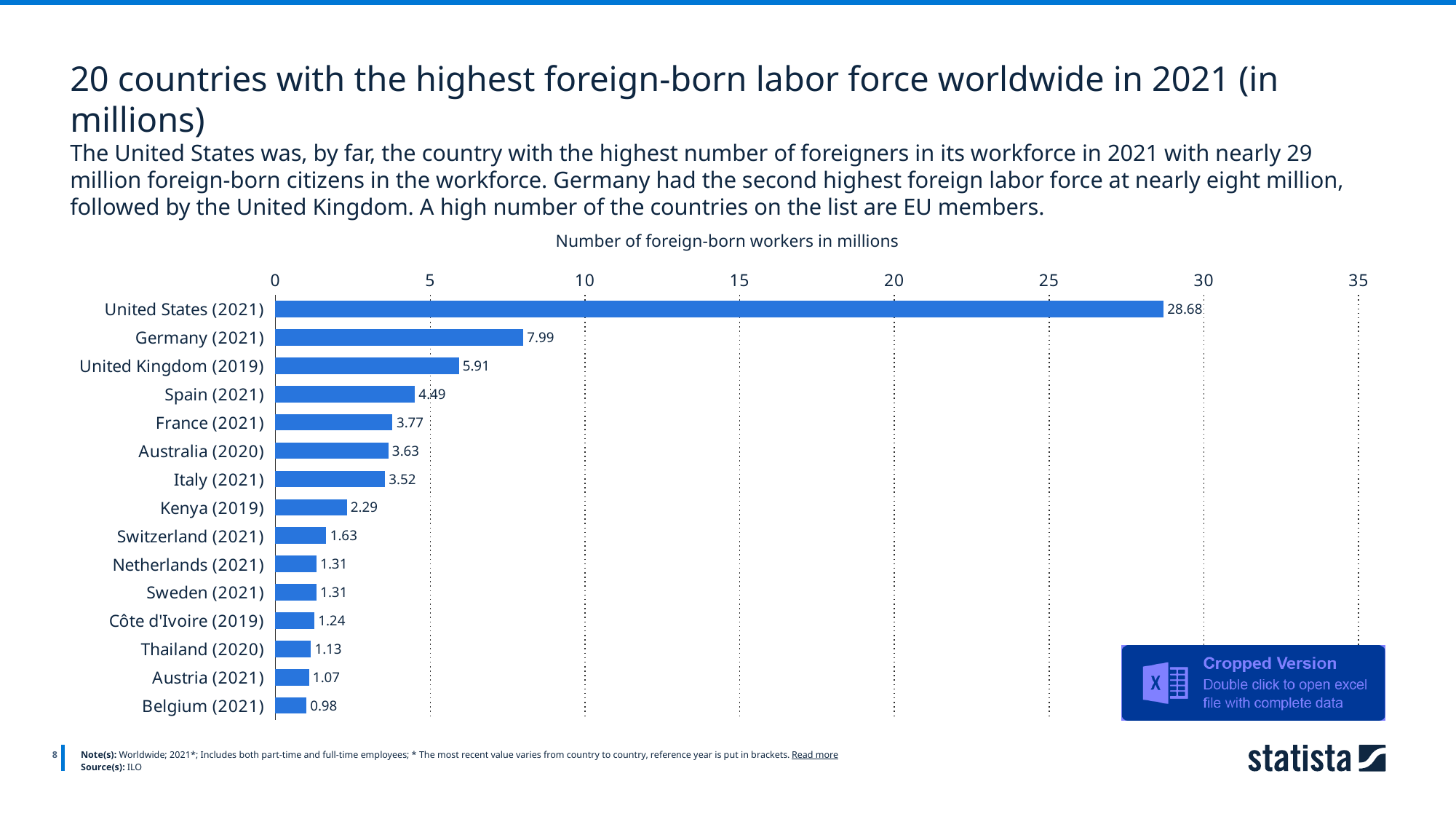
What is the value shown for Côte d'Ivoire (2019)? 1.24 Which has a larger value, Australia (2020) or Italy (2021)? Australia (2020) What is the title of the chart's axis/subtitle shown above the bars? Number of foreign-born workers in millions What is the difference between the values for Spain (2021) and France (2021)? 0.72 Is the value for the United Kingdom (2019) greater or less than 5? greater How many countries are shown on the chart? 15 What is the number of foreign-born workers in millions for Germany (2021)? 7.99 Which country has the lowest value shown on the chart? Belgium (2021) What is the difference between the values for the United States (2021) and Germany (2021)? 20.69 What kind of chart is shown on the slide? Bar chart What is the value shown for Kenya (2019)? 2.29 Which country has the highest number of foreign-born workers on the chart? United States (2021)